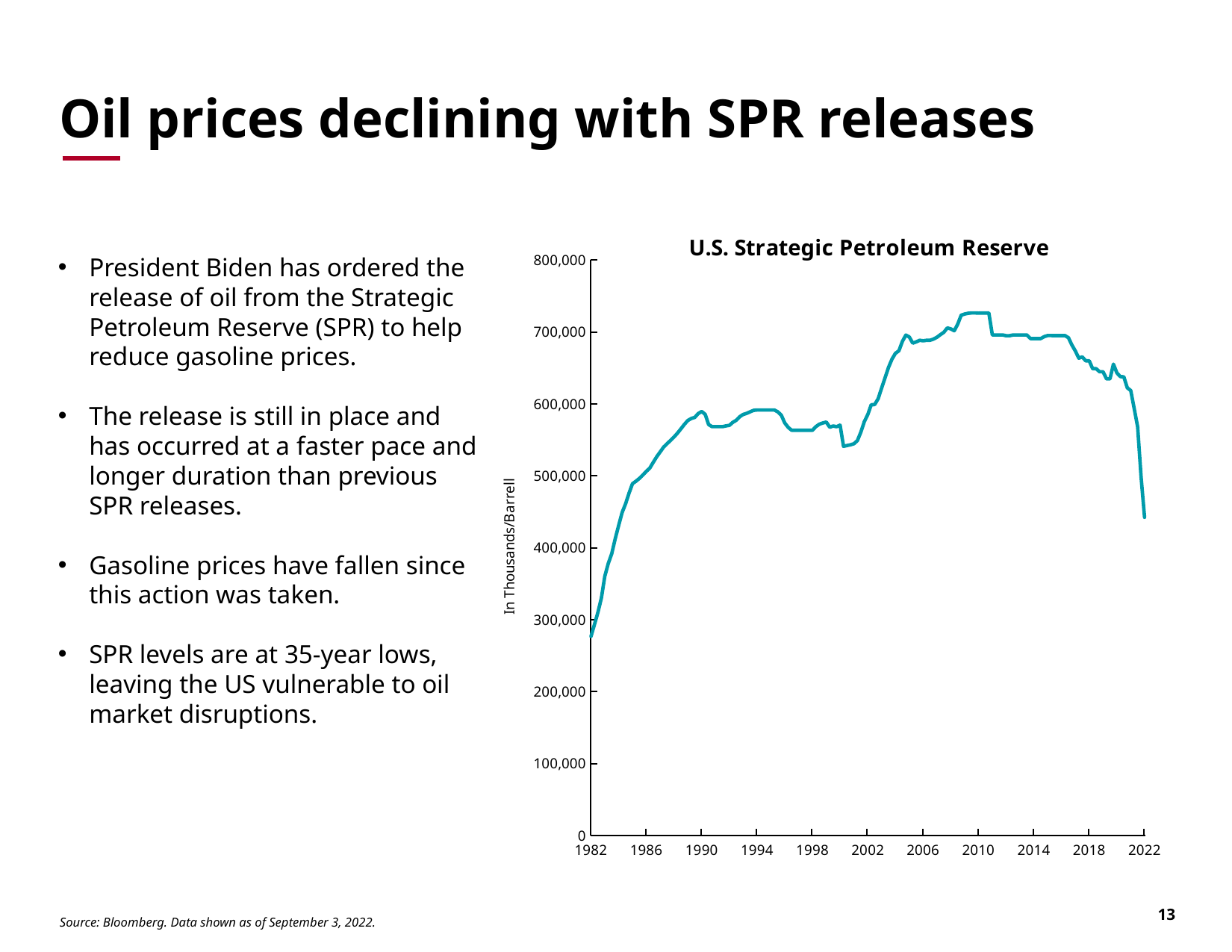
Is the value for 1990 greater or less than 500,000? greater What kind of chart is shown on the slide? line chart What is the title of the chart? U.S. Strategic Petroleum Reserve Is the value for 2006 greater or less than 600,000? greater Which is larger, the value for 2010 or the value for 2022? 2010 Is the value for 2022 greater or less than 500,000? less Does the line rise or fall between 2010 and 2022? fall Does the line rise or fall between 1982 and 1990? rise What is the label on the vertical axis of the chart? In Thousands/Barrell How many year labels are shown on the horizontal axis? 11